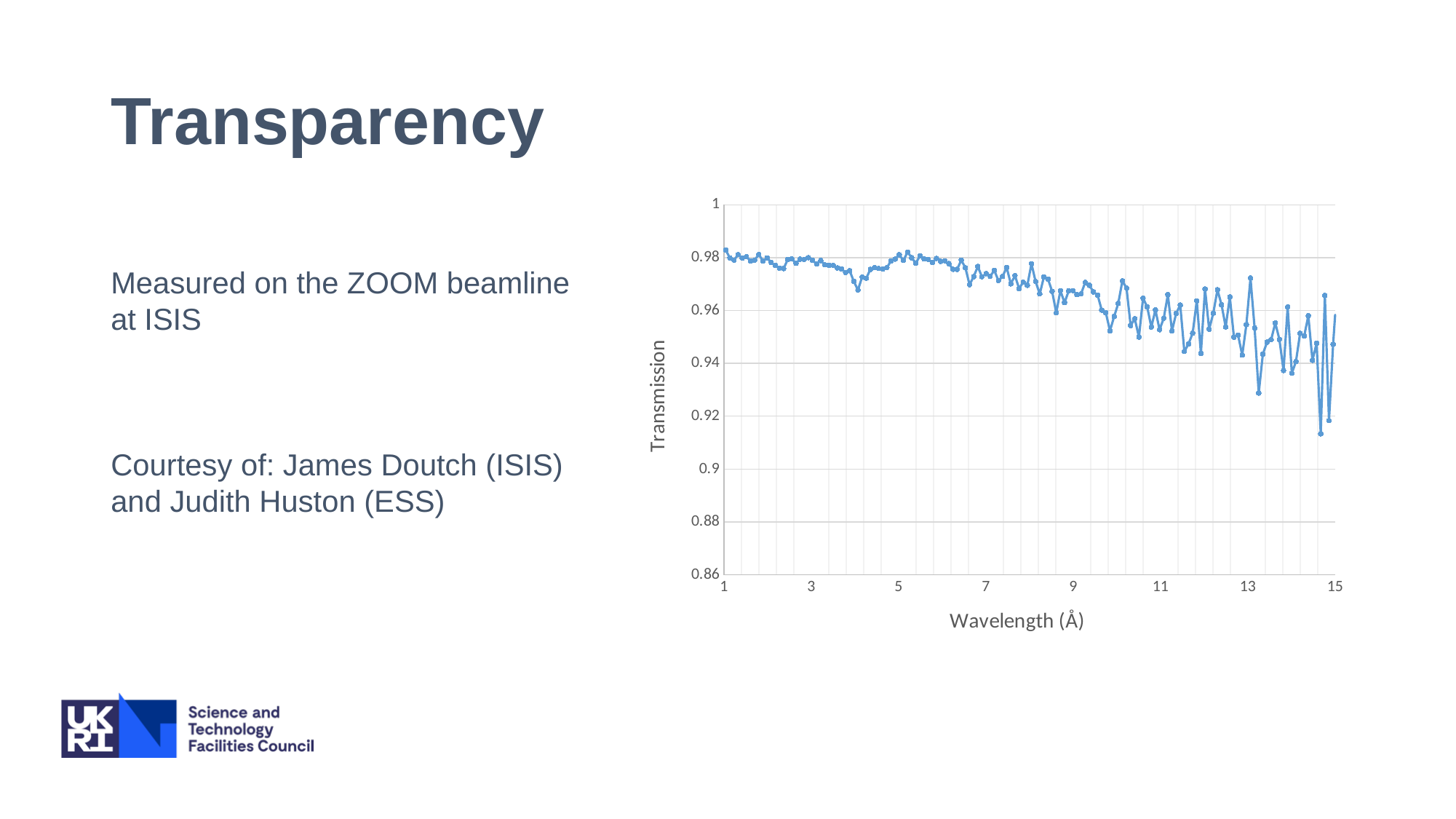
Is the transmission value at a wavelength of 5 Å greater or less than 0.96? greater Is the transmission value at a wavelength of 1 Å greater or less than 0.96? greater Are all the transmission values plotted on the chart greater or less than 0.9? greater Is the transmission at 1 Å larger or smaller than the transmission at 15 Å? larger What is the label of the horizontal axis of the chart? Wavelength (Å) What is the label of the vertical axis of the chart? Transmission What kind of chart is shown on the slide? line chart Overall, does the transmission rise or fall as wavelength increases from 1 to 15 Å? fall